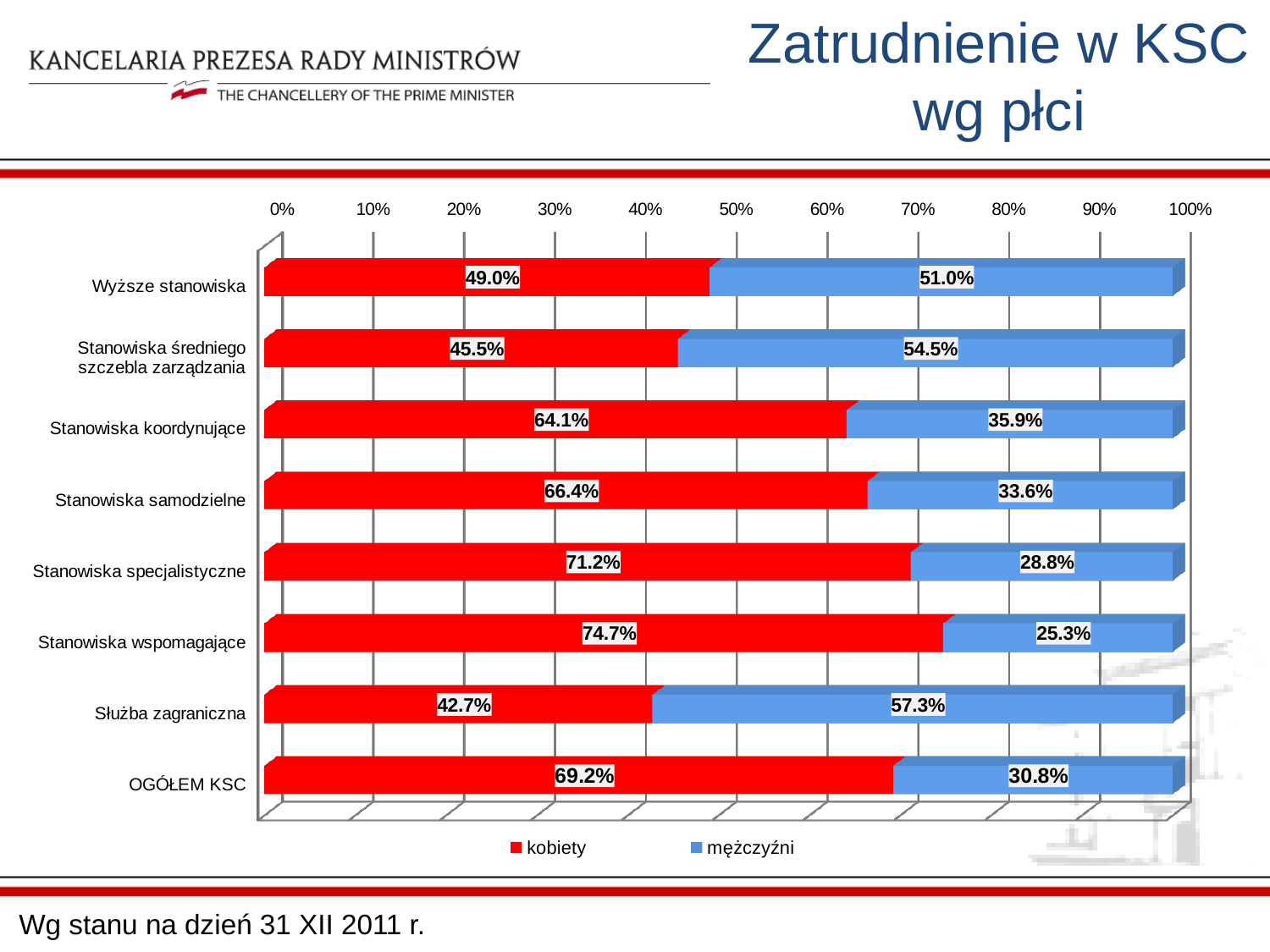
How many series does the legend list? 2 How many categories are shown on the chart? 8 What kind of chart is shown on the slide? Stacked bar chart Which category has the lowest value for kobiety? Służba zagraniczna What is the value for kobiety in the Stanowiska wspomagające category? 74.7% What is the difference between the kobiety and mężczyźni values for Stanowiska koordynujące? 28.2% Which category has the highest value for mężczyźni? Służba zagraniczna Which category has the highest value for kobiety? Stanowiska wspomagające Which is larger for Wyższe stanowiska: the kobiety value or the mężczyźni value? mężczyźni What is the total of the stacked bar for Stanowiska samodzielne? 100% What is the value for kobiety in the OGÓŁEM KSC category? 69.2% What is the value for mężczyźni in the Służba zagraniczna category? 57.3%